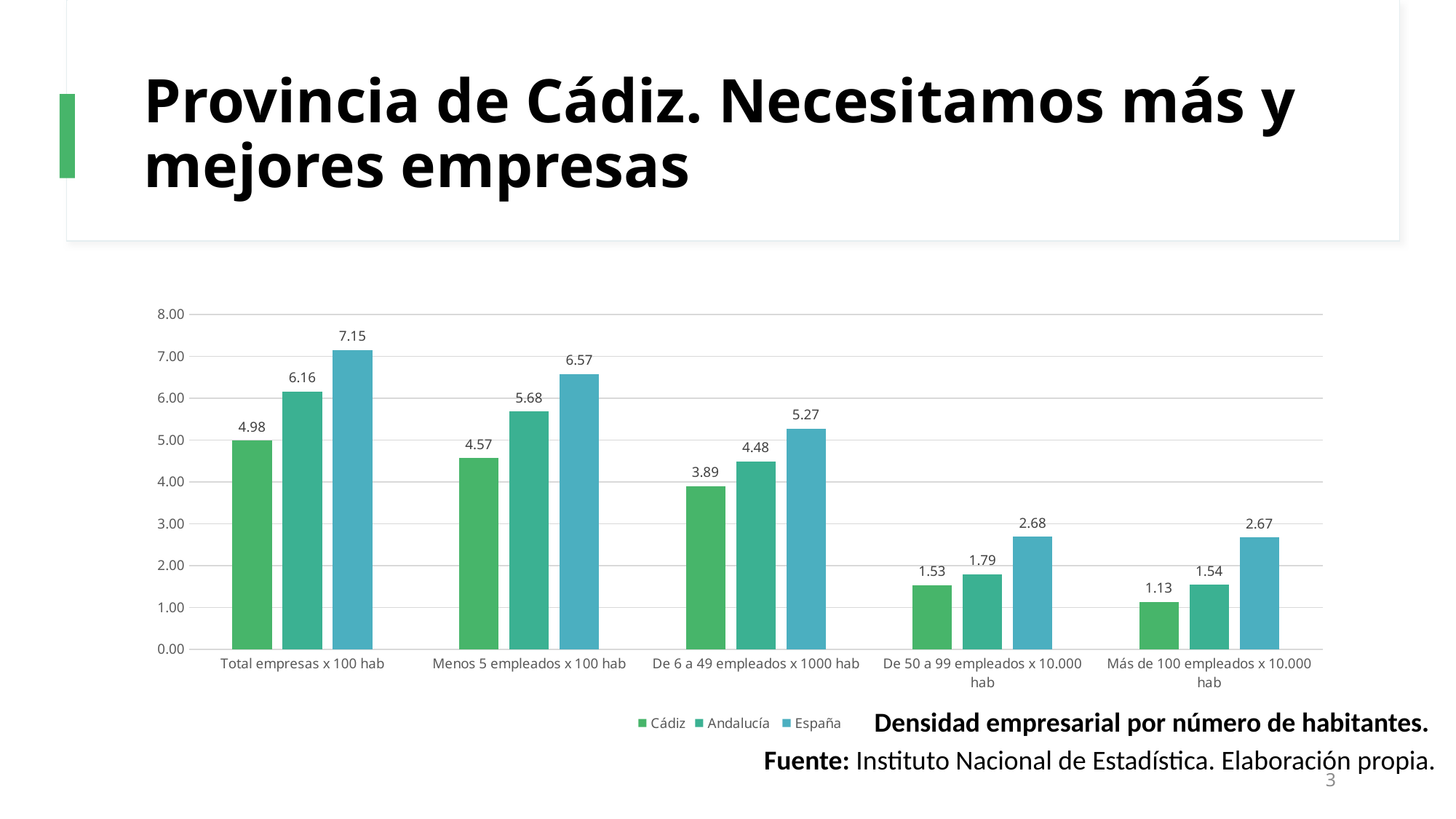
Which category has the lowest value for Cádiz? Más de 100 empleados x 10.000 hab How many categories are shown on the x axis? 5 In the 'De 50 a 99 empleados x 10.000 hab' category, which is larger: the value for Andalucía or the value for Cádiz? Andalucía How many series does the legend list? 3 Which series is shown in the lightest blue colour in the legend? España What is the difference between the España and Cádiz values in the 'Total empresas x 100 hab' category? 2.17 What is the value for España in the 'Menos 5 empleados x 100 hab' category? 6.57 What kind of chart is shown on the slide? Bar chart What is the value for Cádiz in the 'Total empresas x 100 hab' category? 4.98 Which category has the highest value for España? Total empresas x 100 hab What is the value for Cádiz in the 'Más de 100 empleados x 10.000 hab' category? 1.13 What is the value for Andalucía in the 'De 6 a 49 empleados x 1000 hab' category? 4.48